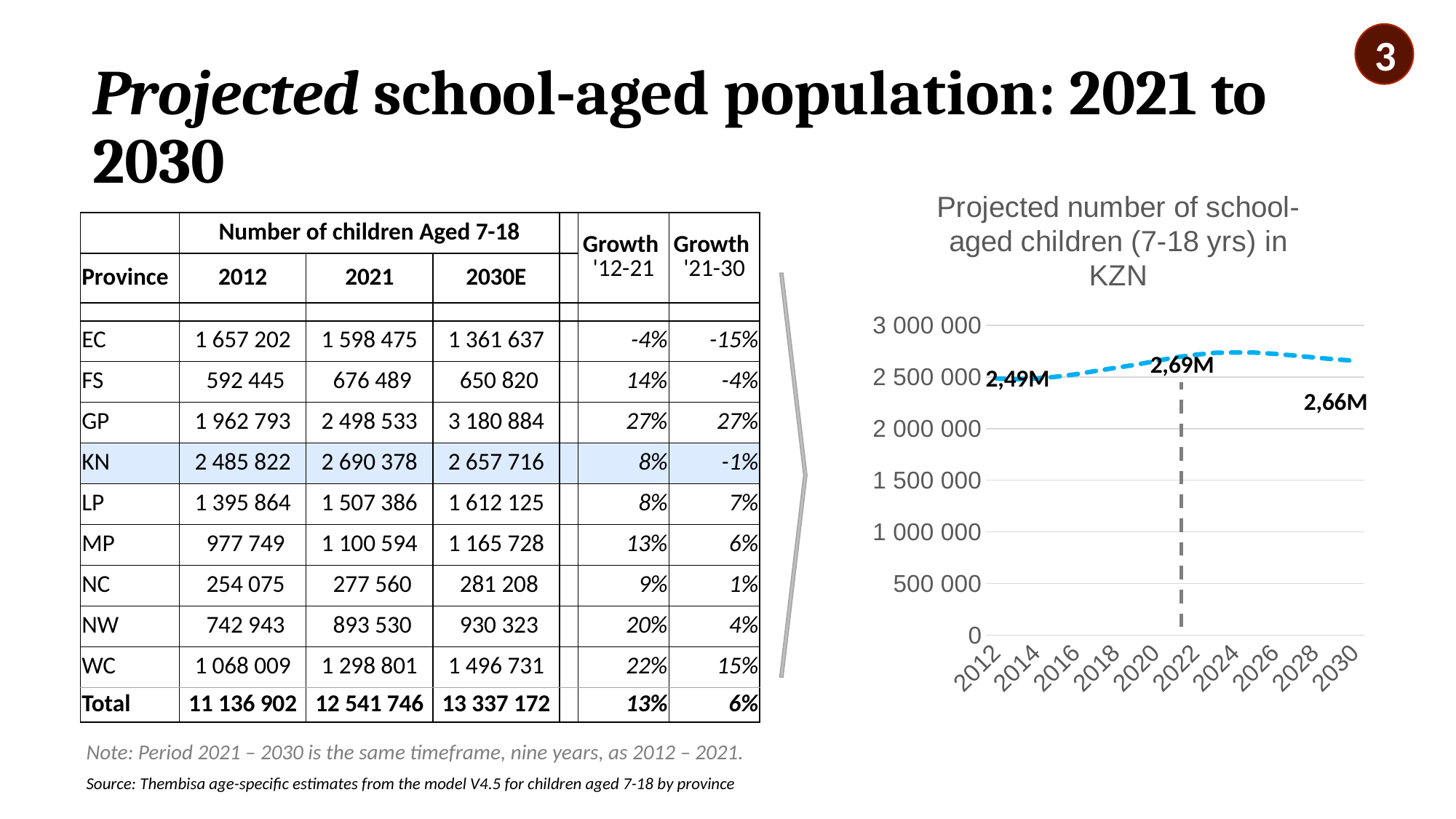
In the chart, does the line rise or fall between 2012 and the peak labelled 2,69M? rise In the chart, what value is labelled at the end of the line in 2030? 2,66M In the chart, is the value for 2030 greater or less than 3 000 000? less What kind of chart is shown on the right of the slide? line chart What is the lowest value labelled on the chart? 2,49M What is the difference between the peak labelled value (2,69M) and the 2012 value (2,49M) in the chart? 0,20M How many year labels are shown on the x axis of the chart? 10 In the chart, is the value for 2012 greater or less than 2 000 000? greater What is the highest value labelled on the chart? 2,69M What is the title of the chart on the right of the slide? Projected number of school-aged children (7-18 yrs) in KZN In the chart, which is larger: the labelled value for 2012 or the labelled value for 2030? 2030 In the chart, what value is labelled for 2012? 2,49M